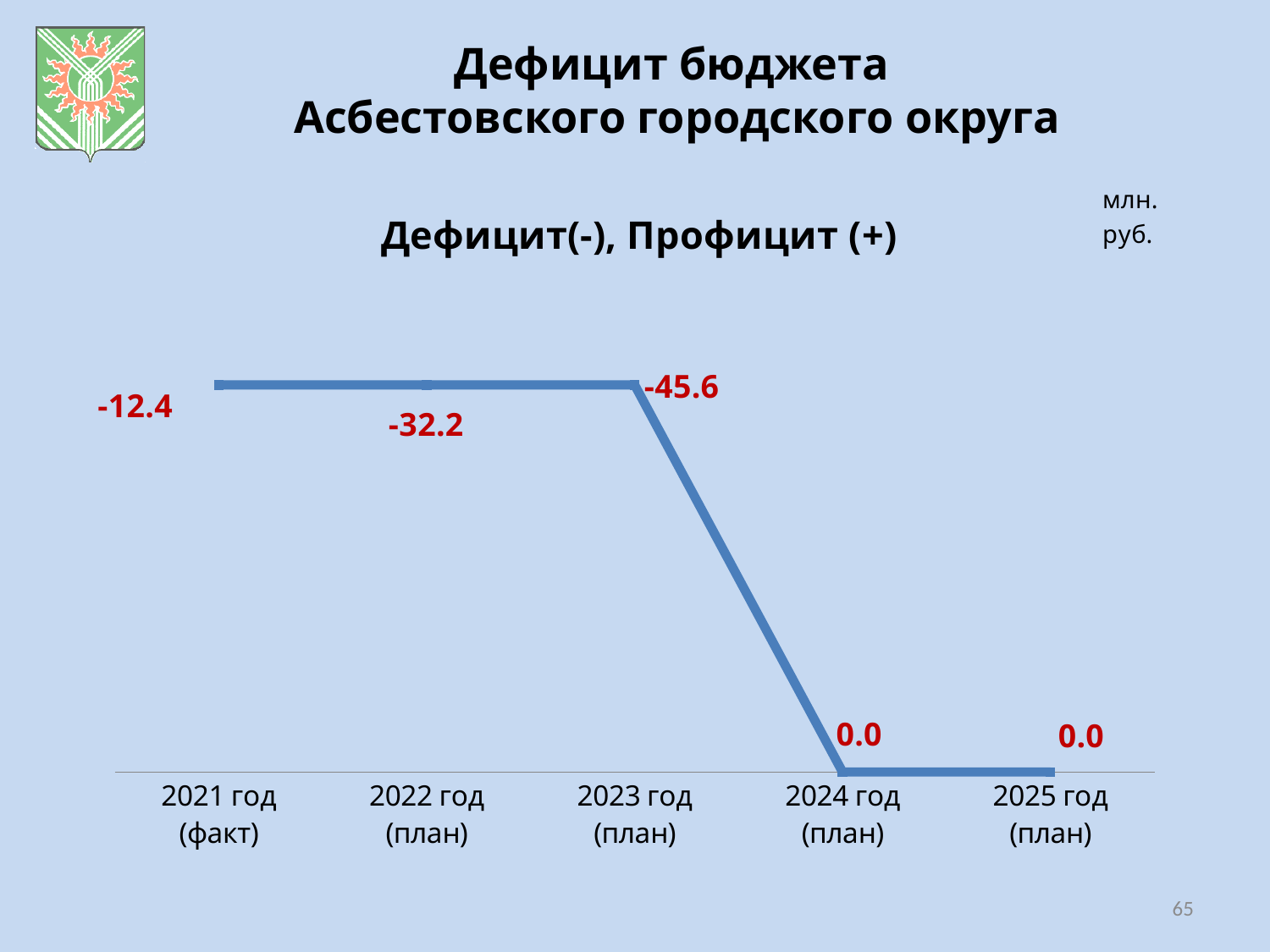
What is the value for 2025 год (план)? 0.0 What is the difference between the values for 2021 год (факт) and 2023 год (план)? 33.2 What is the value for 2021 год (факт)? -12.4 What is the value for 2024 год (план)? 0.0 How many years are plotted on the chart? 5 What is the difference between the values for 2021 год (факт) and 2022 год (план)? 19.8 What kind of chart is shown? line chart Which is larger, the value for 2021 год (факт) or the value for 2023 год (план)? 2021 год (факт) What is the value for 2022 год (план)? -32.2 What is the value for 2023 год (план)? -45.6 Do the values rise or fall from 2021 год (факт) to 2023 год (план)? fall Which year has the lowest value? 2023 год (план)